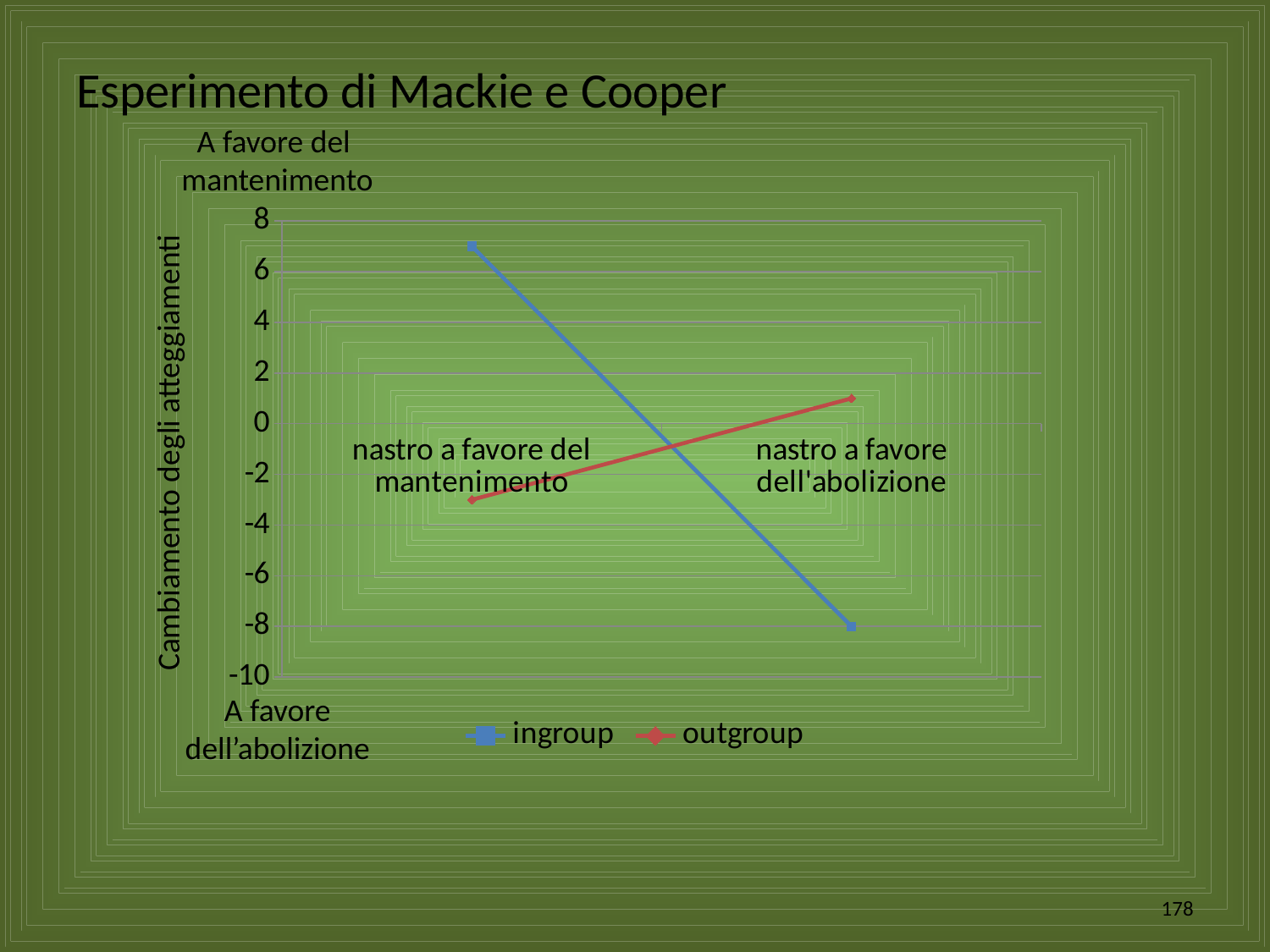
Is the outgroup value for 'nastro a favore dell'abolizione' greater or less than 0? greater Is the ingroup value for 'nastro a favore del mantenimento' greater or less than 6? greater Is the outgroup value for 'nastro a favore del mantenimento' greater or less than -2? less Does the ingroup line rise or fall from 'nastro a favore del mantenimento' to 'nastro a favore dell'abolizione'? fall What kind of chart is shown on the slide? line chart For 'nastro a favore dell'abolizione', which series has the higher value, ingroup or outgroup? outgroup For 'nastro a favore del mantenimento', which series has the higher value, ingroup or outgroup? ingroup What are the two series named in the legend? ingroup and outgroup How many categories are plotted along the x axis? 2 What is the title of the slide containing the chart? Esperimento di Mackie e Cooper How many series does the legend list? 2